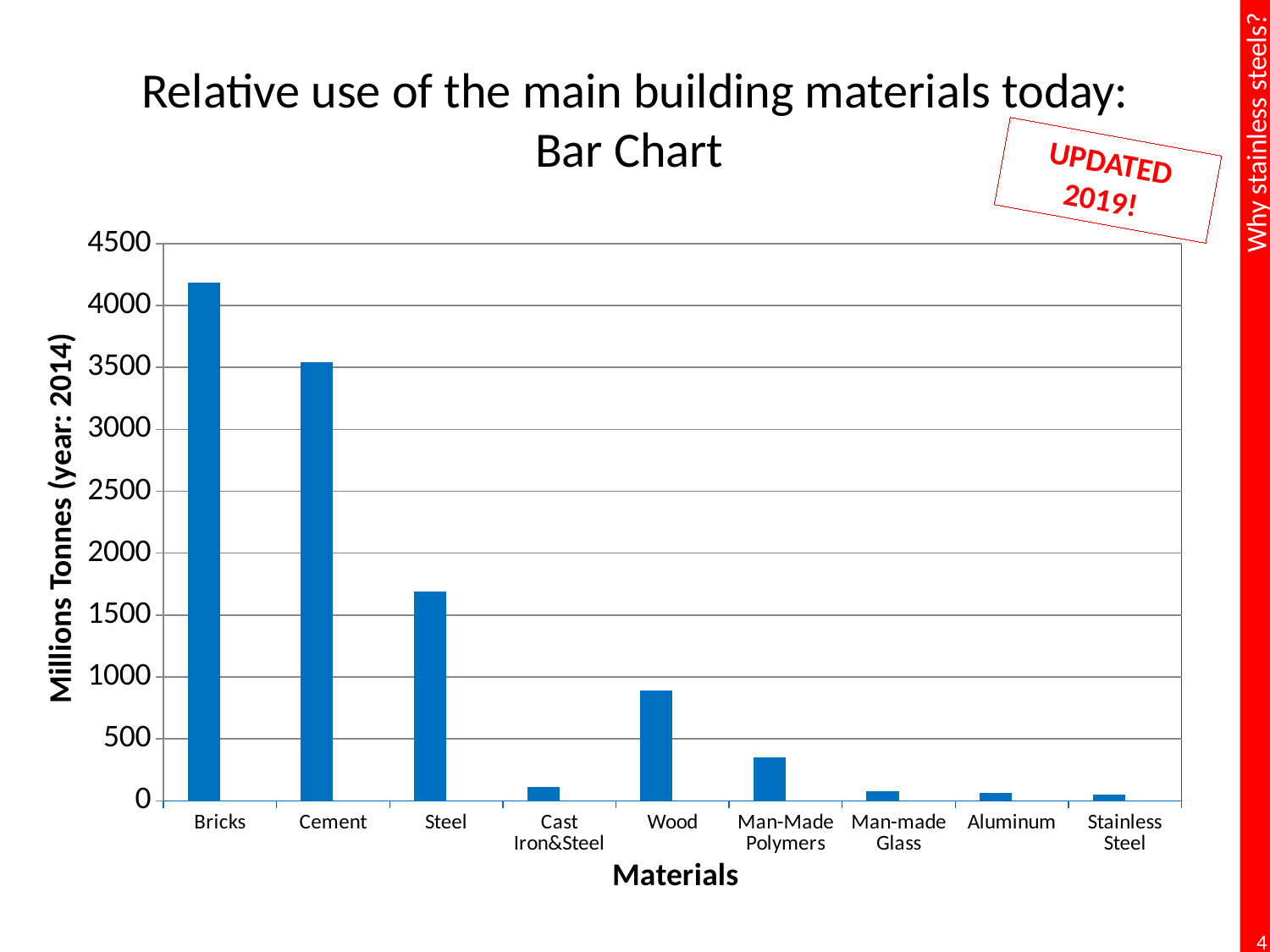
Is the value for Cast Iron&Steel greater or less than 500? less What is the label of the y axis? Millions Tonnes (year: 2014) How many materials are plotted on the x axis? 9 What kind of chart is shown on the slide? bar chart Which is larger, the value for Steel or the value for Wood? Steel Which is larger, the value for Bricks or the value for Cement? Bricks Is the value for Cement greater or less than 3000? greater Is the value for Wood greater or less than 1000? less Which material has the highest value? Bricks Which is larger, the value for Wood or the value for Man-Made Polymers? Wood